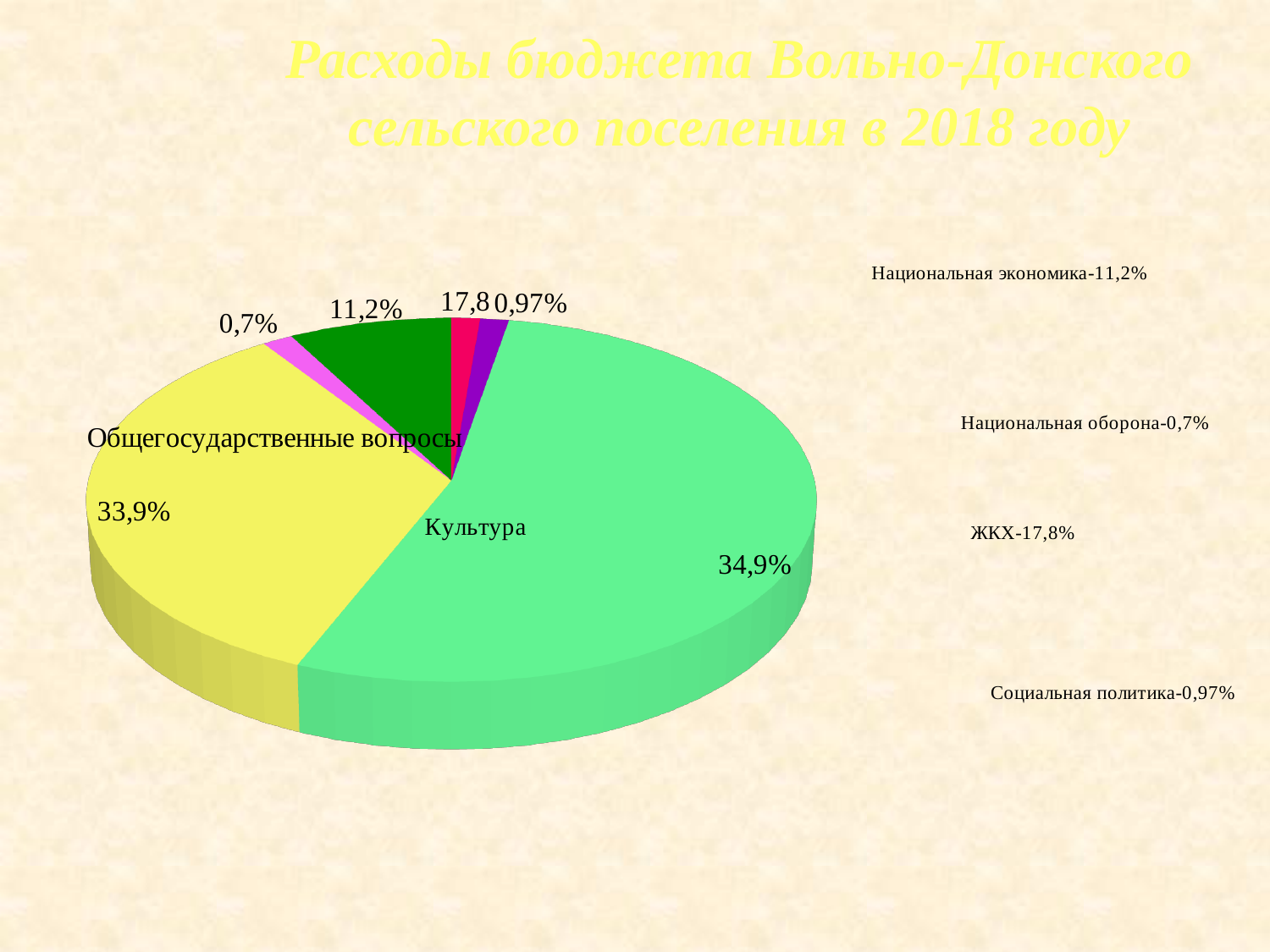
What share is shown for ЖКХ? 17,8% How many slices does the pie chart have? 6 What share is shown for Национальная экономика? 11,2% What type of chart is shown on the slide? pie chart What share of the budget expenses goes to Общегосударственные вопросы? 33,9% Which is larger, the share for ЖКХ or the share for Национальная экономика? ЖКХ Which category has the smallest share of the pie? Национальная оборона What is the difference between the shares for ЖКХ and Национальная экономика? 6,6% What share of the budget expenses goes to Культура? 34,9% What share is shown for Социальная политика? 0,97% Which category has the largest share of the pie? Культура What is the title of the chart on the slide? Расходы бюджета Вольно-Донского сельского поселения в 2018 году